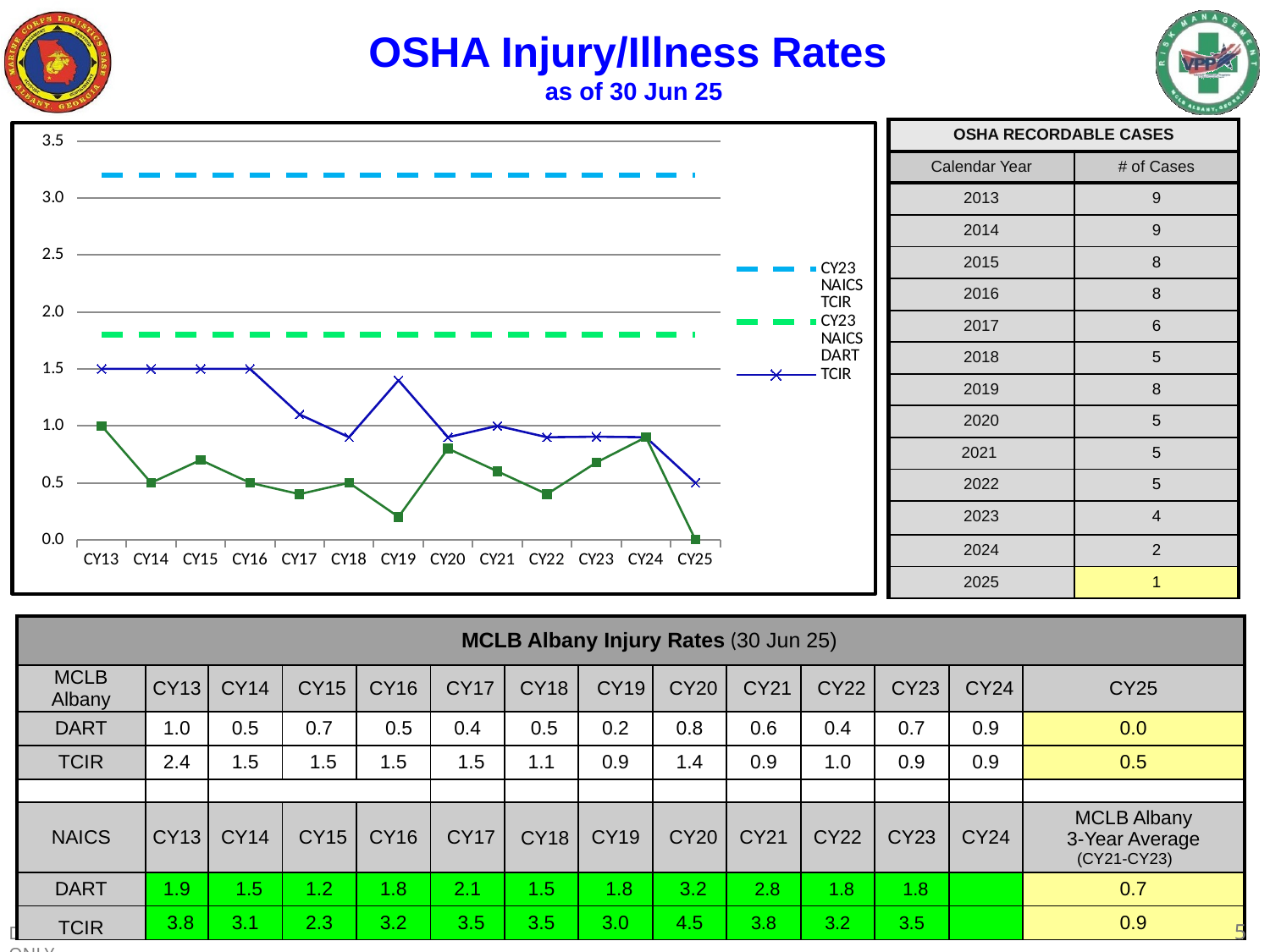
In which year is the DART rate highest? CY13 Is the CY23 NAICS DART reference line greater or less than 2.0? less What kind of chart is shown on the slide? line chart At CY16, which is larger, the TCIR or the DART rate? TCIR What is the difference between the DART rate in CY13 and in CY25? 1.0 Is the CY23 NAICS TCIR reference line greater or less than 3.0? greater How many calendar years are plotted along the x axis of the chart? 13 What is the DART rate for CY25? 0.0 How many entries does the chart legend list? 3 In which year is the DART rate lowest? CY25 Is the TCIR value for CY25 greater or less than 1.0? less What is the DART rate for CY19? 0.2